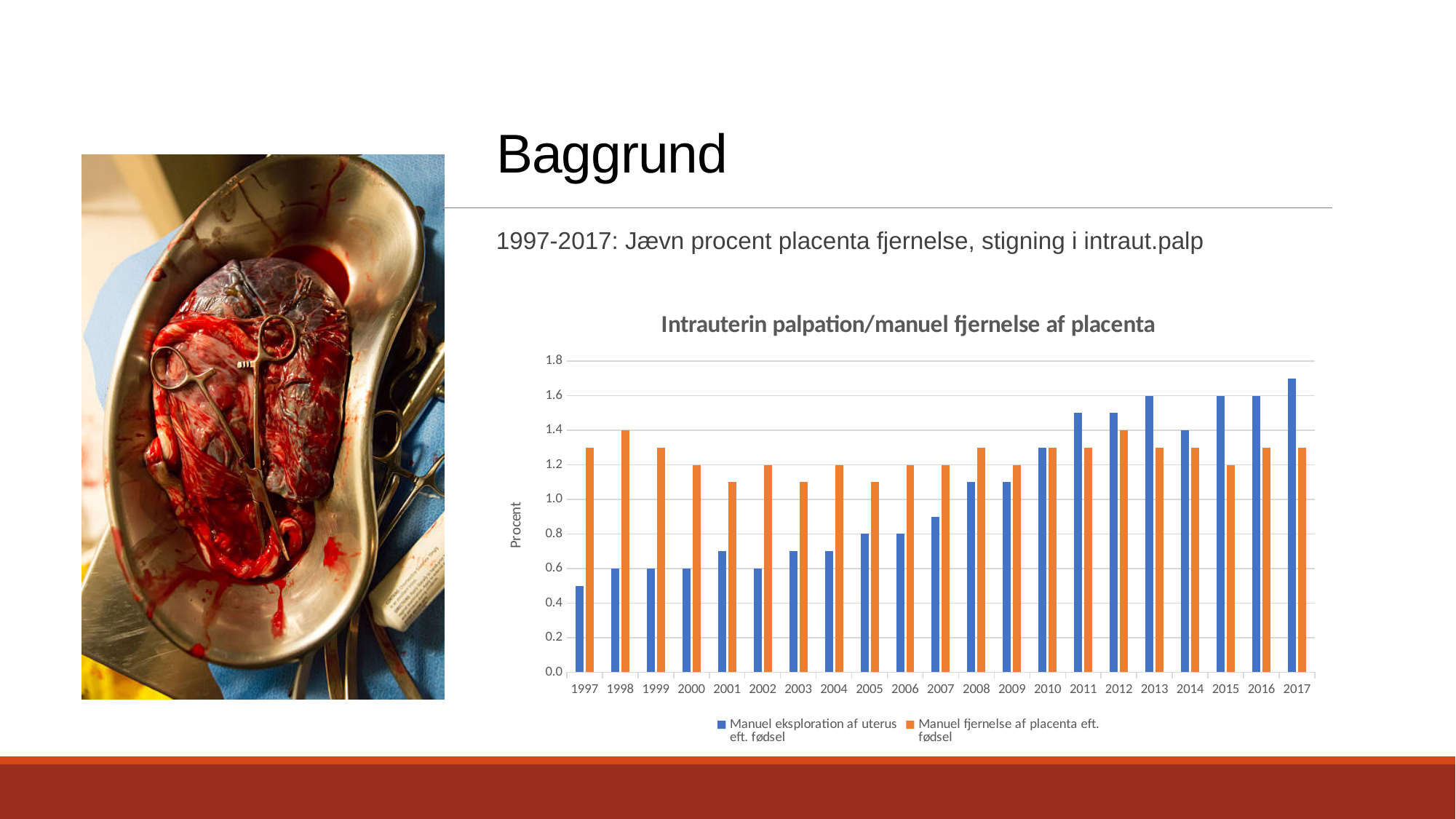
Is the value for 'Manuel eksploration af uterus eft. fødsel' in 1997 greater or less than 1.0? less In which year is the value for 'Manuel eksploration af uterus eft. fødsel' highest? 2017 Does the value for 'Manuel eksploration af uterus eft. fødsel' generally rise or fall from 1997 to 2017? rise In 1997, which series has the larger value: 'Manuel eksploration af uterus eft. fødsel' or 'Manuel fjernelse af placenta eft. fødsel'? Manuel fjernelse af placenta eft. fødsel In 2017, which series has the larger value: 'Manuel eksploration af uterus eft. fødsel' or 'Manuel fjernelse af placenta eft. fødsel'? Manuel eksploration af uterus eft. fødsel Is the value for 'Manuel eksploration af uterus eft. fødsel' in 2017 greater or less than 1.4? greater What kind of chart is shown on the slide? bar chart How many series does the legend of the chart list? 2 How many years are shown on the x axis of the chart? 21 What is the label on the vertical axis of the chart? Procent Is the value for 'Manuel fjernelse af placenta eft. fødsel' in 2005 greater or less than 1.0? greater What is the title of the chart? Intrauterin palpation/manuel fjernelse af placenta